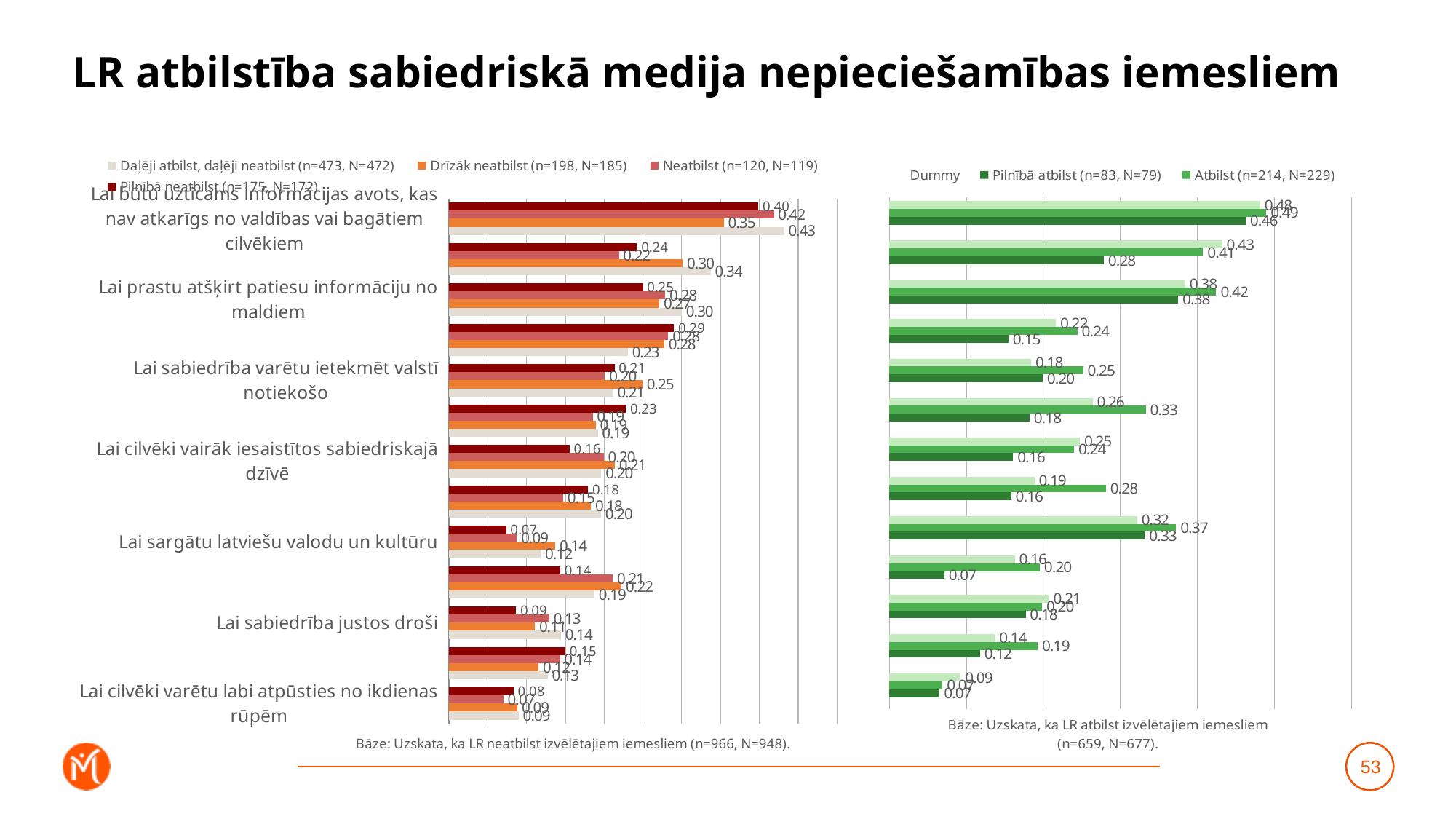
In the left chart, what is the value of 'Drīzāk neatbilst' for 'Lai būtu uzticams informācijas avots, kas nav atkarīgs no valdības vai bagātiem cilvēkiem'? 0.35 What is the base (Bāze) stated under the left chart? Uzskata, ka LR neatbilst izvēlētajiem iemesliem (n=966, N=948) How many series does the legend of the right chart list? 3 In the right chart, what is the value of 'Pilnībā atbilst' for 'Lai prastu atšķirt patiesu informāciju no maldiem'? 0.38 In the right chart, what is the value of 'Atbilst' for 'Lai sargātu latviešu valodu un kultūru'? 0.37 In the left chart, what is the value of 'Daļēji atbilst, daļēji neatbilst' for 'Lai būtu uzticams informācijas avots, kas nav atkarīgs no valdības vai bagātiem cilvēkiem'? 0.43 How many series does the legend of the left chart list? 4 In the right chart, what is the value of 'Atbilst' for 'Lai cilvēki varētu labi atpūsties no ikdienas rūpēm'? 0.07 In the left chart, what is the value of 'Pilnībā neatbilst' for 'Lai sargātu latviešu valodu un kultūru'? 0.07 In the right chart, what is the difference between 'Atbilst' and 'Pilnībā atbilst' for 'Lai sargātu latviešu valodu un kultūru'? 0.04 In the left chart, which is larger for 'Lai sabiedrība justos droši': 'Neatbilst' or 'Pilnībā neatbilst'? Neatbilst What kind of chart is the left chart on the slide? bar chart